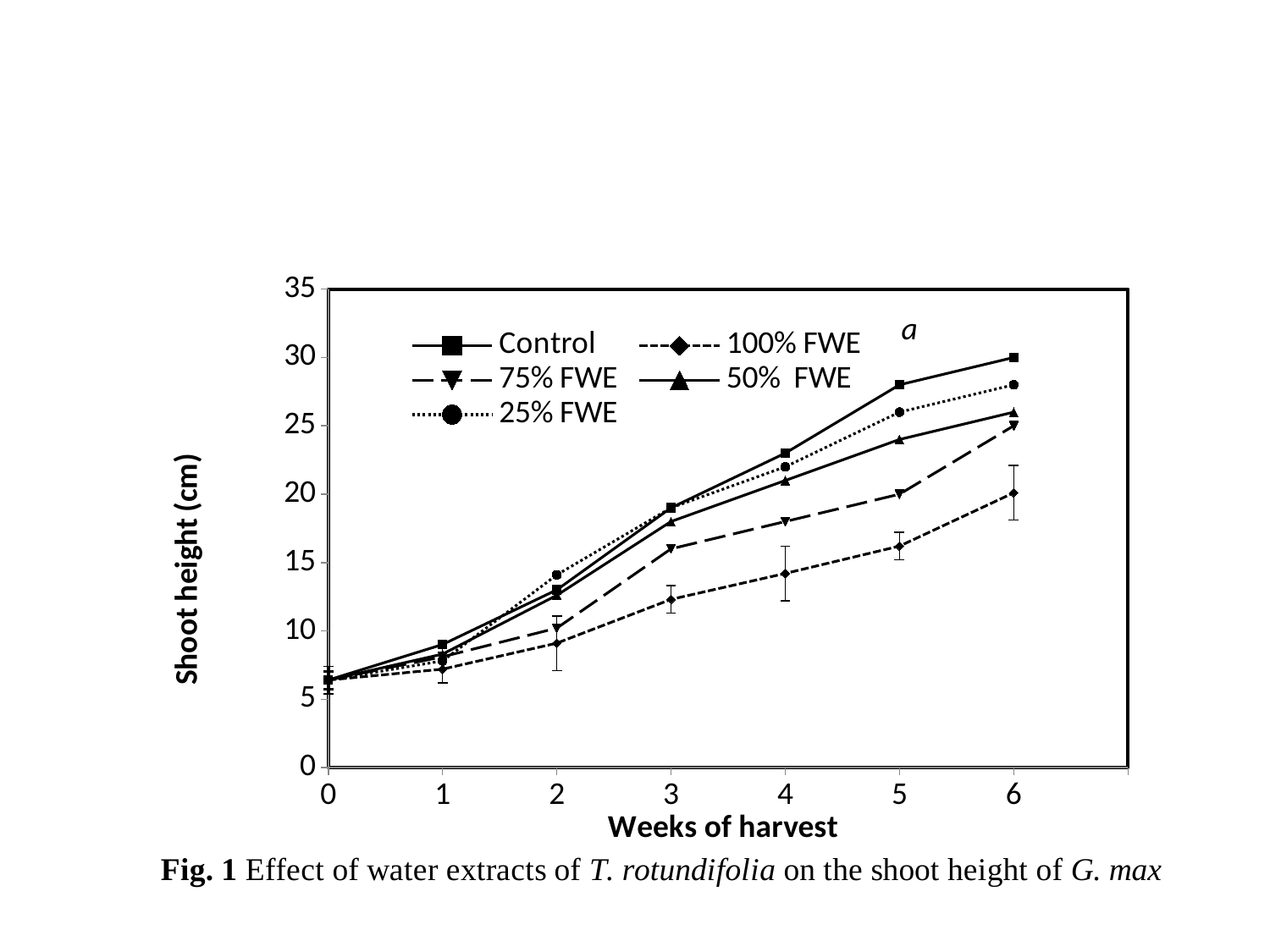
Is the shoot height for Control at week 6 greater or less than 25? greater How many series does the legend list? 5 At week 4, which is larger: the shoot height for 25% FWE or for 75% FWE? 25% FWE What kind of chart is shown on the slide? line chart At week 5, which is larger: the shoot height for Control or for 100% FWE? Control Is the shoot height for 100% FWE at week 3 greater or less than 15? less Which series has the highest shoot height at week 6? Control Which series has the lowest shoot height at week 6? 100% FWE How many weeks are plotted along the x axis? 7 Is the shoot height for 100% FWE at week 6 greater or less than 25? less Does the shoot height for Control rise or fall from week 0 to week 6? rise What is the title of the y axis? Shoot height (cm)